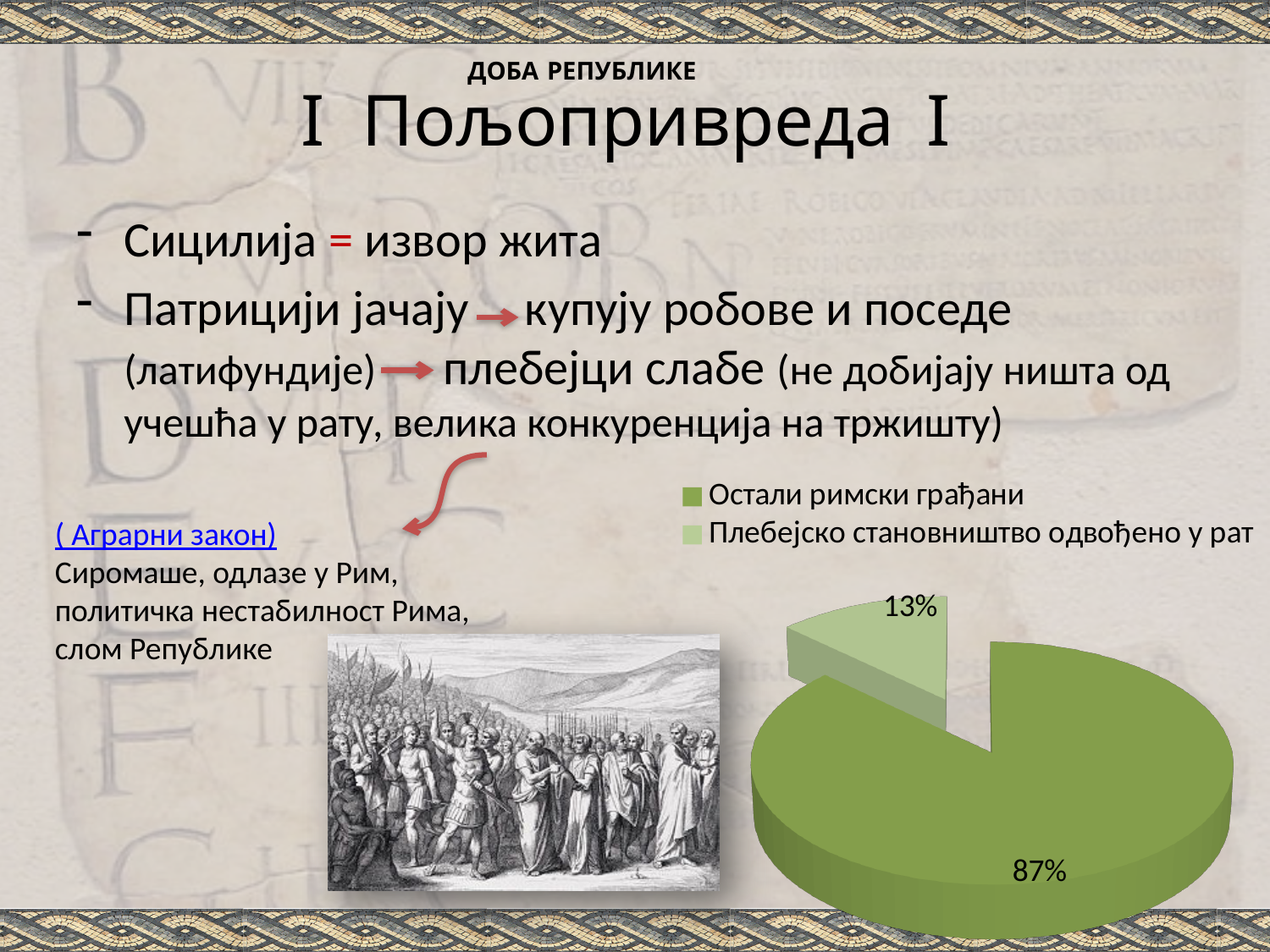
Which is larger: the share for "Остали римски грађани" or the share for "Плебејско становништво одвођено у рат"? Остали римски грађани What colour is the "Остали римски грађани" slice in the pie chart? dark green How many slices does the pie chart have? 2 How many entries does the legend of the pie chart list? 2 What share of the pie does "Плебејско становништво одвођено у рат" take? 13% Which slice of the pie chart is the smallest? Плебејско становништво одвођено у рат What kind of chart is shown on the slide? pie chart Which slice of the pie chart is pulled out (exploded) from the rest of the pie? Плебејско становништво одвођено у рат What share of the pie does "Остали римски грађани" take? 87% What is the difference in percentage points between the "Остали римски грађани" slice and the "Плебејско становништво одвођено у рат" slice? 74 Which slice of the pie chart is the largest? Остали римски грађани